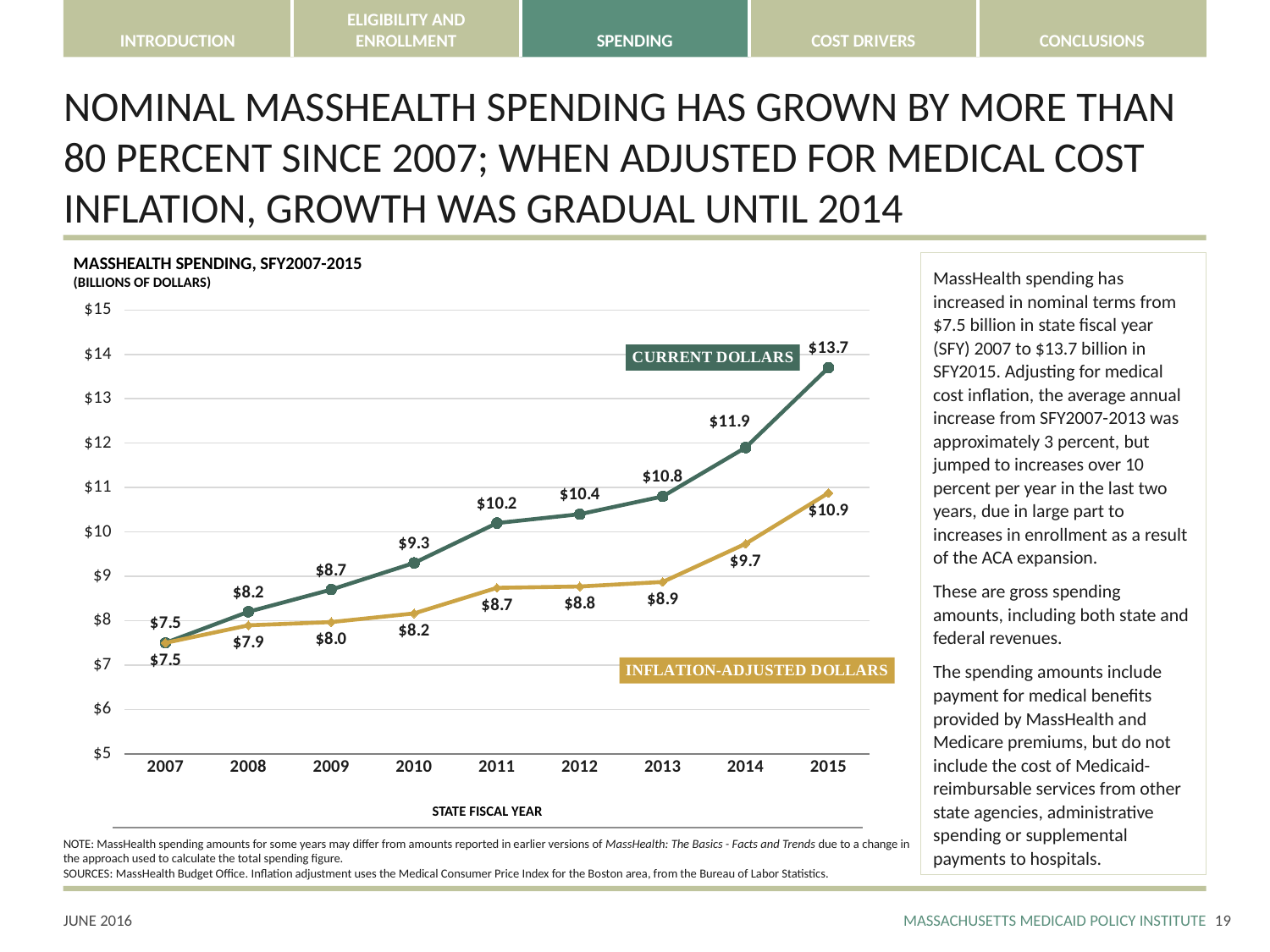
In which year was inflation-adjusted spending lowest? 2007 By how much did current-dollar spending increase from 2007 to 2015? $6.2 Does inflation-adjusted spending rise or fall from 2007 to 2015? Rise How many data series does the chart show? 2 What is the difference between current-dollar and inflation-adjusted spending in 2015? $2.8 What was MassHealth spending in current dollars in 2015? $13.7 What was MassHealth spending in current dollars in 2011? $10.2 Which is larger in 2013: current-dollar spending or inflation-adjusted spending? Current dollars What type of chart is shown on the slide? Line chart In which year was current-dollar spending highest? 2015 What was MassHealth spending in inflation-adjusted dollars in 2014? $9.7 How many state fiscal years are plotted on the x axis? 9